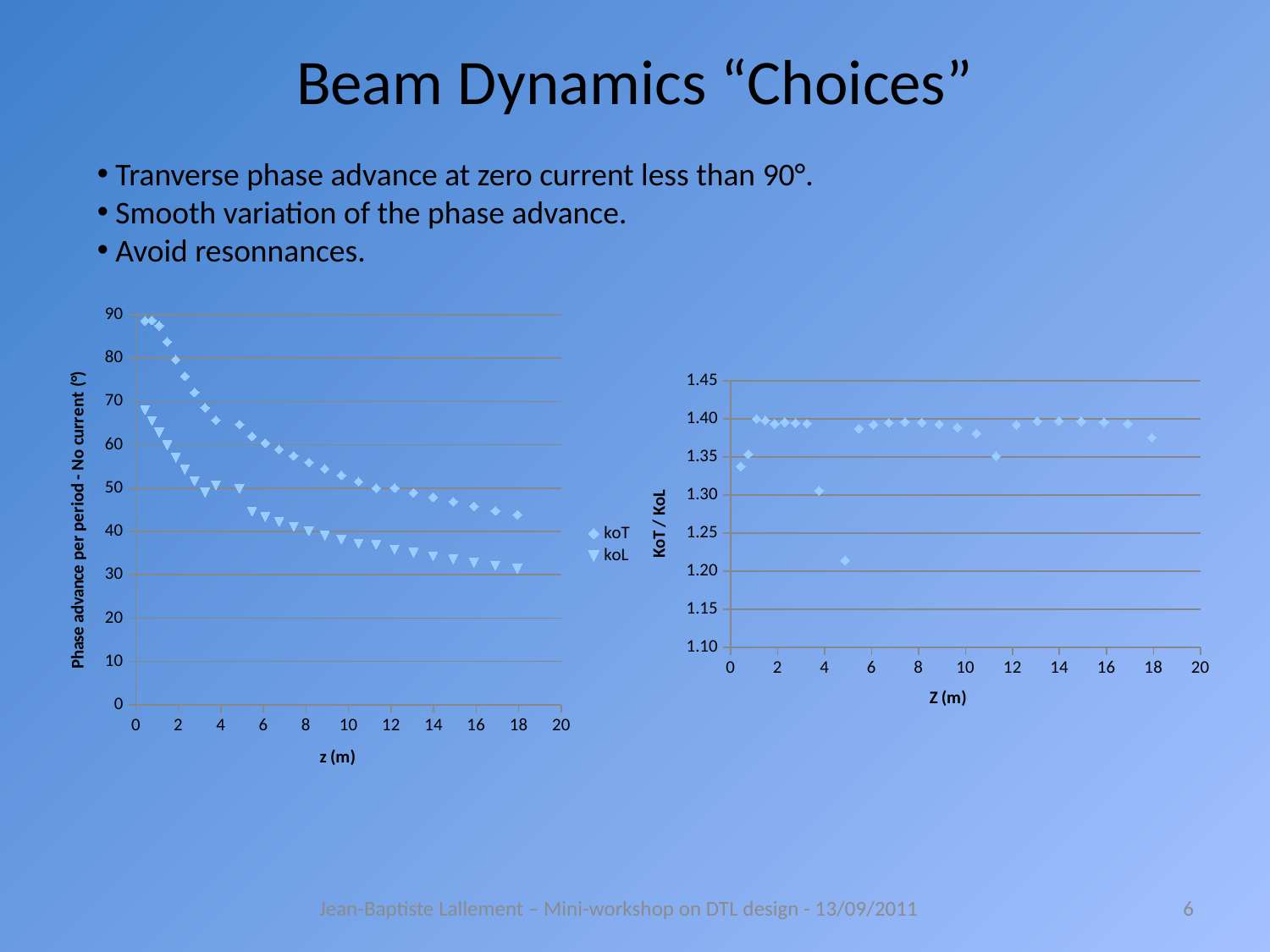
On the left chart, is the koT value at z = 18 greater or less than 40? greater On the left chart, what are the names of the two series in the legend? koT and koL On the left chart, at z = 10, which series has the larger value, koT or koL? koT On the left chart, do the koL values rise or fall as z increases? fall On the left chart, is the koT value at z = 2 greater or less than 70? greater What kind of chart is the right chart (KoT / KoL versus Z)? scatter chart On the right chart, is the KoT / KoL value at Z = 8 greater or less than 1.35? greater On the left chart, do the koT values rise or fall as z increases? fall What is the y-axis title of the right chart? KoT / KoL On the left chart, how many series does the legend list? 2